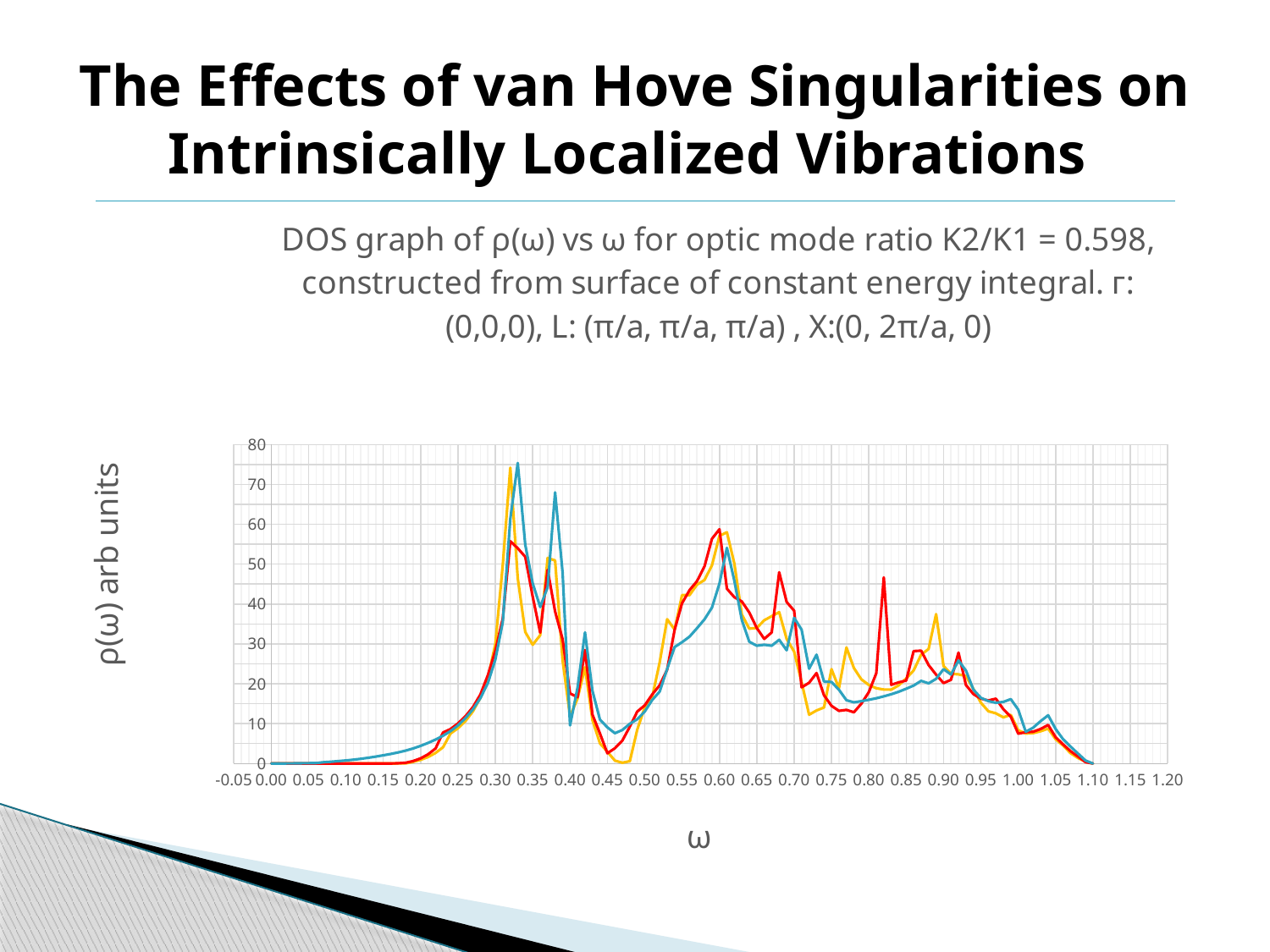
How many lines are plotted on the chart? 3 Is the peak of the red line near ω = 0.60 greater or less than 50? greater Is the sharp red spike near ω = 0.82 greater or less than 40? greater Is the highest peak of the blue line, near ω = 0.33, greater or less than 70? greater What kind of chart is shown on the slide? line chart What is the label of the vertical axis of the chart? ρ(ω) arb units What is the label of the horizontal axis of the chart? ω What is the highest tick value shown on the vertical axis? 80 What is the highest tick value shown on the horizontal axis? 1.20